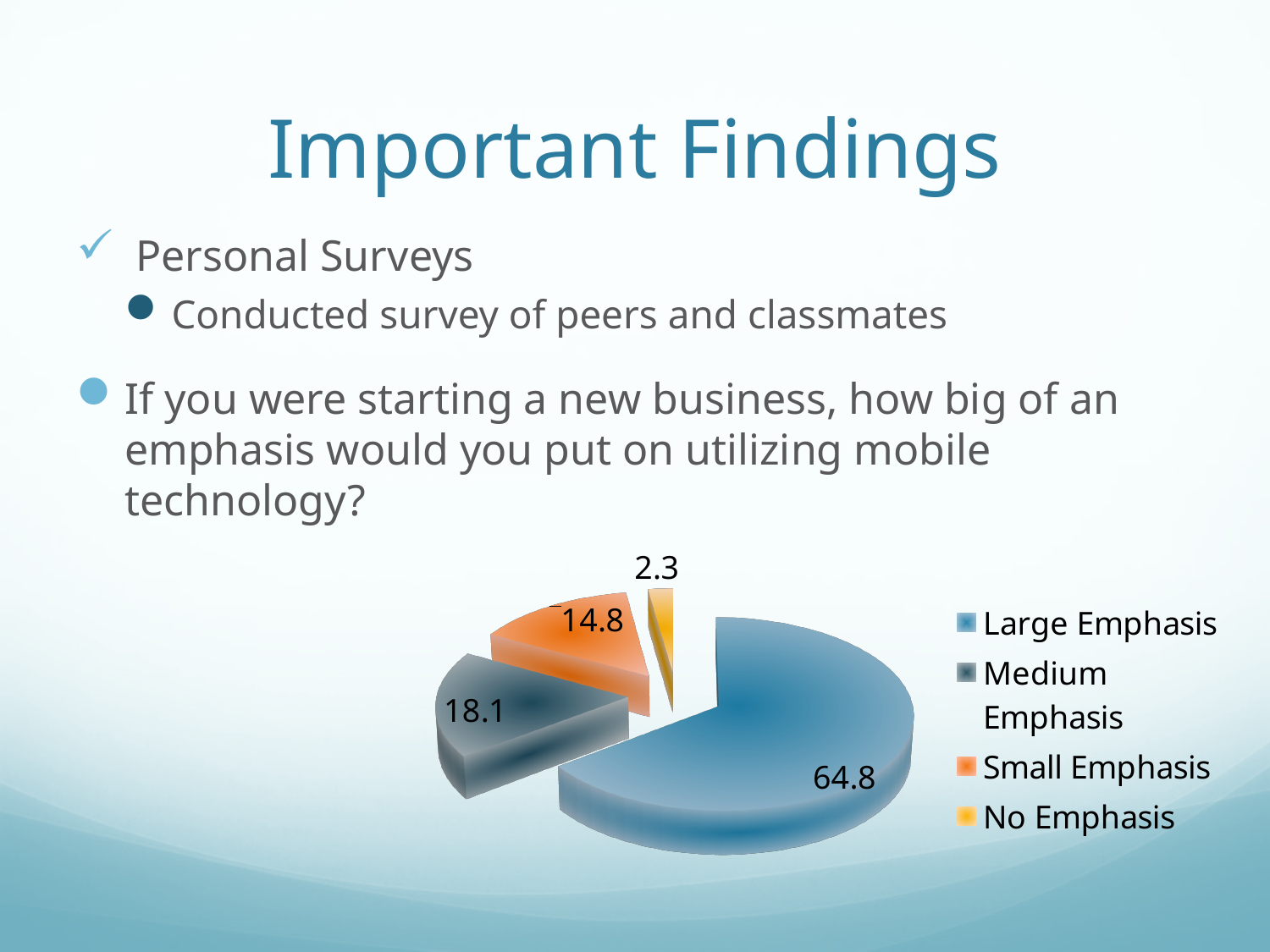
Which category has the smallest slice in the pie chart? No Emphasis Which is larger, the value for Medium Emphasis or the value for Small Emphasis? Medium Emphasis What is the value shown for Large Emphasis in the pie chart? 64.8 What is the difference between the values for Large Emphasis and Medium Emphasis? 46.7 What is the difference between the values for Small Emphasis and No Emphasis? 12.5 Which category has the largest slice in the pie chart? Large Emphasis What colour is the Large Emphasis slice in the pie chart? blue What is the value shown for No Emphasis in the pie chart? 2.3 How many categories does the pie chart show? 4 What kind of chart is shown on the slide? pie chart What is the value shown for Medium Emphasis in the pie chart? 18.1 What is the value shown for Small Emphasis in the pie chart? 14.8